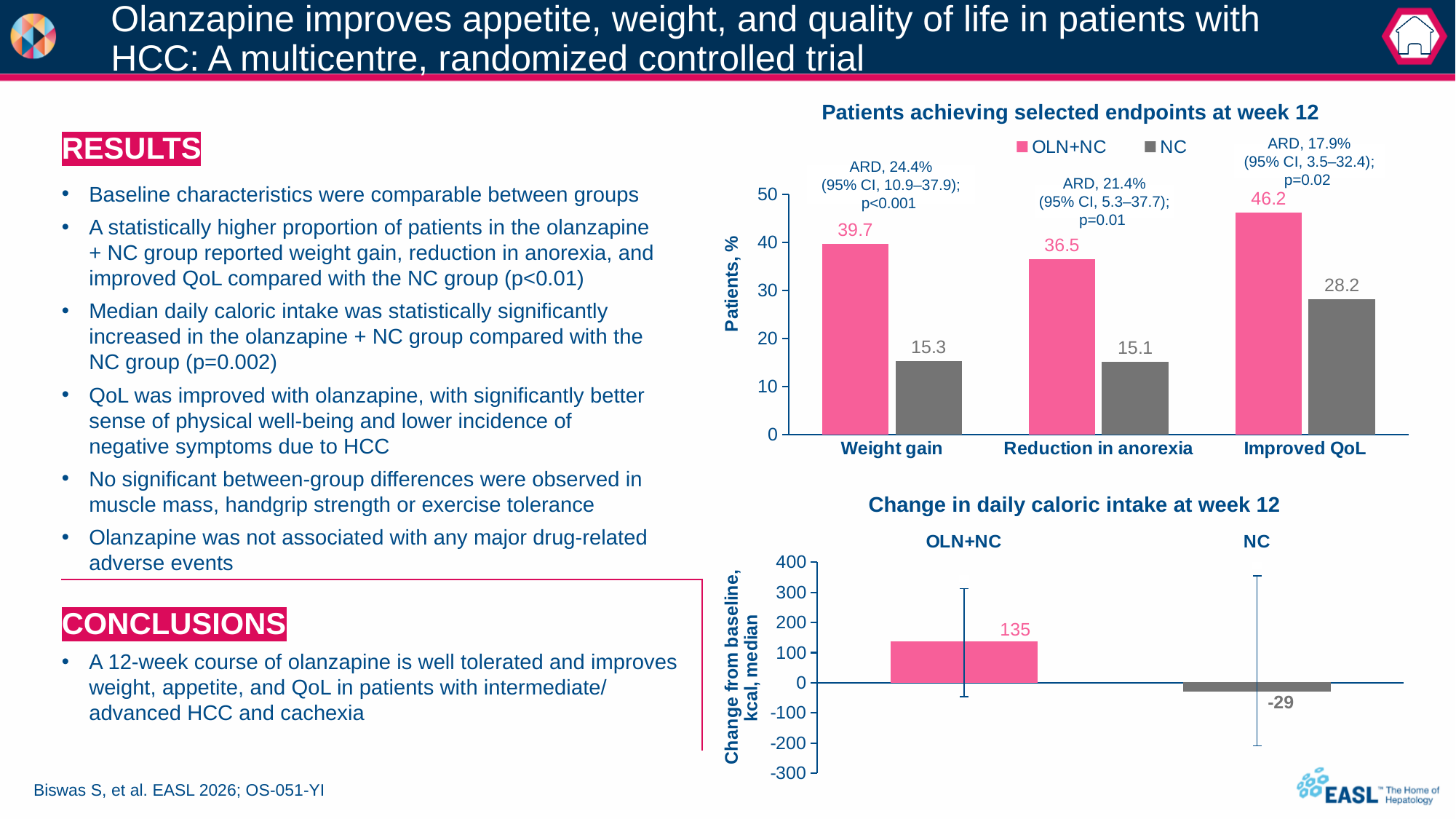
How many categories are shown on the x axis of the 'Patients achieving selected endpoints at week 12' chart? 3 In the 'Change in daily caloric intake at week 12' chart, what is the median change from baseline for the OLN+NC group? 135 In the 'Patients achieving selected endpoints at week 12' chart, what colour are the OLN+NC bars? Pink In the 'Patients achieving selected endpoints at week 12' chart, what is the value for NC in the Reduction in anorexia category? 15.1 How many series does the legend of the 'Patients achieving selected endpoints at week 12' chart list? 2 In the 'Patients achieving selected endpoints at week 12' chart, which group has the larger value for Weight gain, OLN+NC or NC? OLN+NC What type of chart is the 'Change in daily caloric intake at week 12' chart? Bar chart In the 'Patients achieving selected endpoints at week 12' chart, which category has the highest OLN+NC value? Improved QoL In the 'Change in daily caloric intake at week 12' chart, what is the median change from baseline for the NC group? -29 In the 'Patients achieving selected endpoints at week 12' chart, what is the difference between the OLN+NC and NC values for Improved QoL? 18.0 In the 'Patients achieving selected endpoints at week 12' chart, what percentage of OLN+NC patients achieved weight gain? 39.7 In the 'Patients achieving selected endpoints at week 12' chart, which category has the lowest NC value? Reduction in anorexia